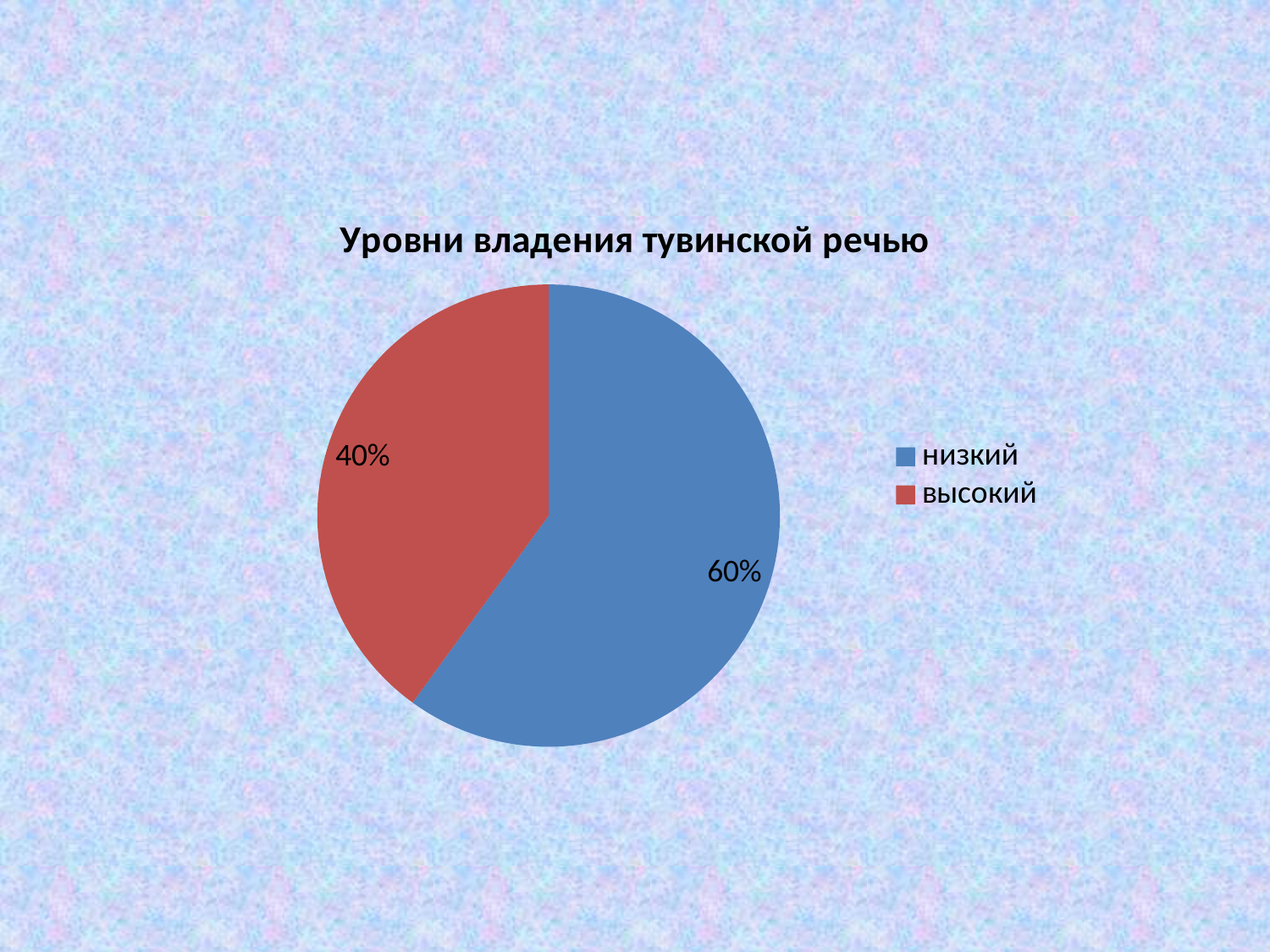
Which category has the smallest slice of the pie? высокий What is the difference in percentage points between the 'низкий' and 'высокий' slices? 20% Which is larger, the 'низкий' slice or the 'высокий' slice? низкий What kind of chart is shown on the slide? pie chart What is the title of the chart? Уровни владения тувинской речью What share of the pie does the 'низкий' slice take? 60% How many entries does the legend list? 2 What share of the pie does the 'высокий' slice take? 40% What colour is the 'высокий' slice? red Which category has the largest slice of the pie? низкий How many slices does the pie chart have? 2